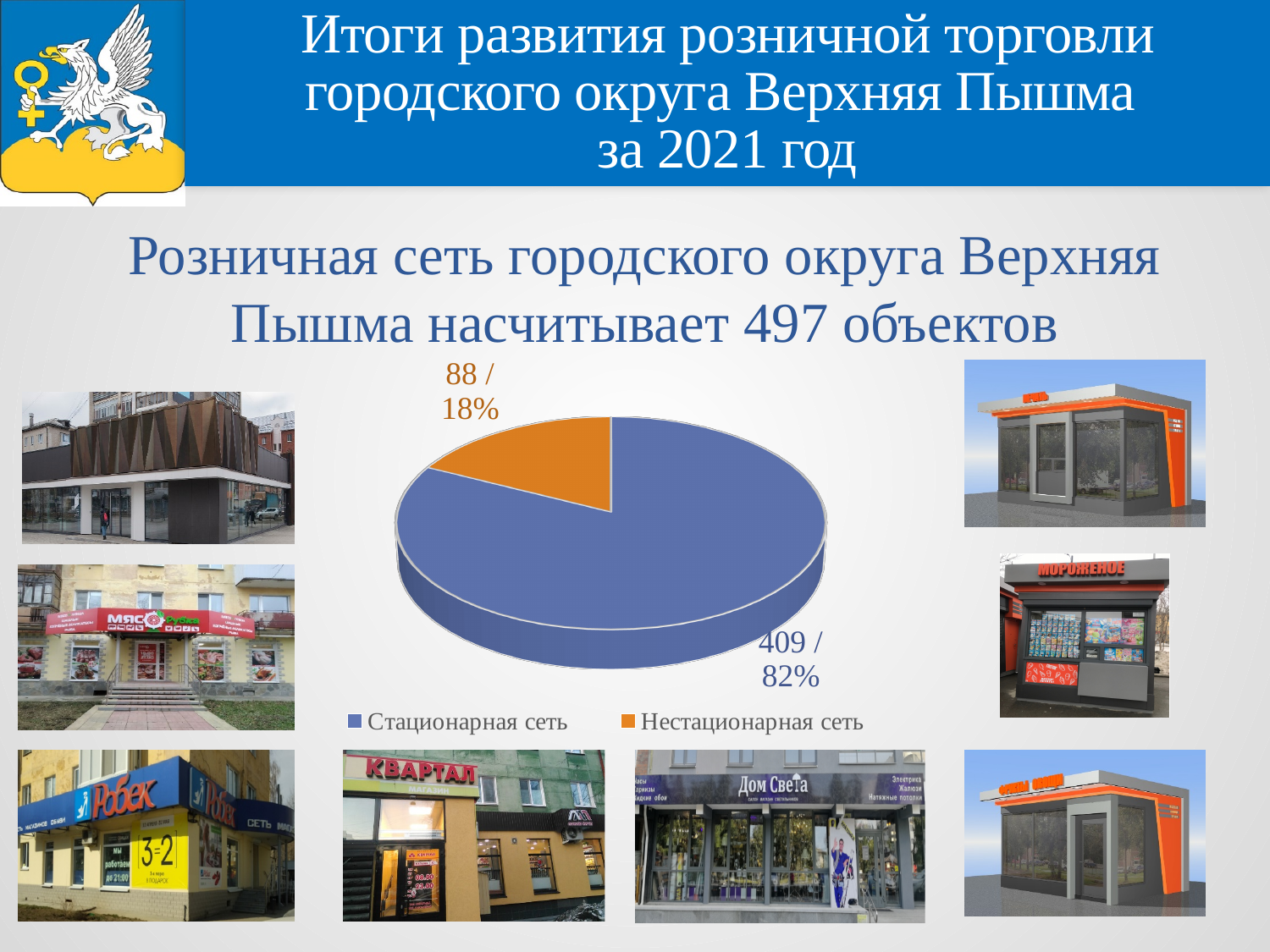
What share of the pie does Стационарная сеть represent? 82% What share of the pie does Нестационарная сеть represent? 18% What is the number of objects for Нестационарная сеть? 88 What kind of chart is shown on the slide? pie chart What is the difference between the values for Стационарная сеть and Нестационарная сеть? 321 How many series does the legend list? 2 Which category has the smallest slice? Нестационарная сеть What is the total of the two slices in the pie chart? 497 What is the number of objects for Стационарная сеть? 409 How many slices does the pie chart have? 2 Which colour represents Нестационарная сеть in the pie chart? orange Which category has the largest slice? Стационарная сеть